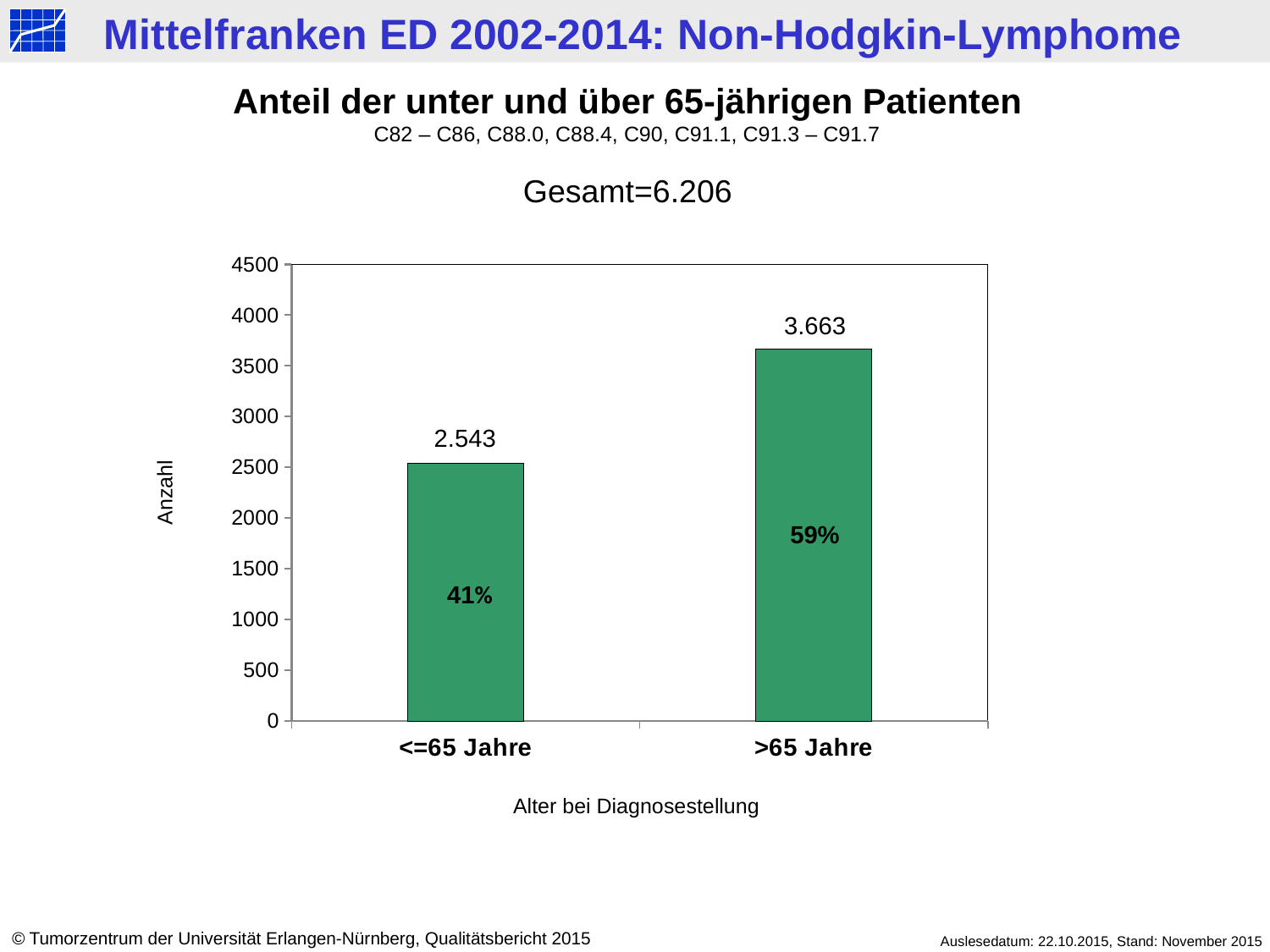
How many categories are shown on the x axis? 2 Which age category has the highest value? >65 Jahre Which is larger, the value for <=65 Jahre or for >65 Jahre? >65 Jahre Is the value for <=65 Jahre greater or less than 3000? less What is the difference between the values for >65 Jahre and <=65 Jahre? 1.120 What is the label of the y axis? Anzahl What kind of chart is shown on the slide? bar chart What is the value for the <=65 Jahre category? 2.543 Which age category has the lowest value? <=65 Jahre What is the value for the >65 Jahre category? 3.663 What percentage is shown inside the >65 Jahre bar? 59% What percentage is shown inside the <=65 Jahre bar? 41%